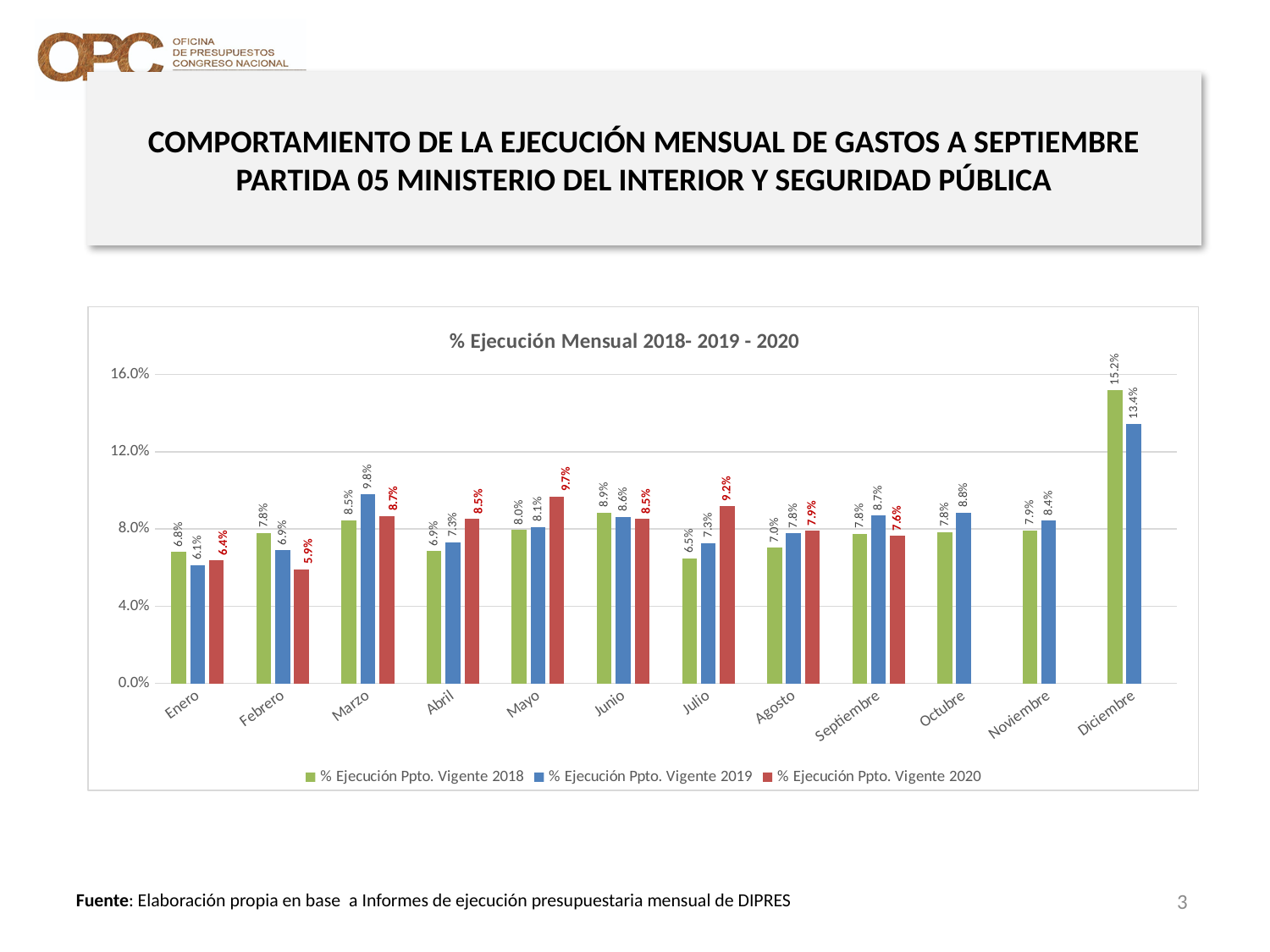
What is the difference between the 2018 and 2019 values for Diciembre? 1.8% Is the value for Diciembre in the % Ejecución Ppto. Vigente 2019 series greater or less than 12.0%? greater Which month has the highest value in the % Ejecución Ppto. Vigente 2019 series? Diciembre What is the value for Marzo in the % Ejecución Ppto. Vigente 2019 series? 9.8% What is the value for Diciembre in the % Ejecución Ppto. Vigente 2018 series? 15.2% How many series does the legend list? 3 Which month has the lowest value in the % Ejecución Ppto. Vigente 2020 series? Febrero What kind of chart is shown on the slide? Bar chart What is the value for Mayo in the % Ejecución Ppto. Vigente 2020 series? 9.7% How many months are shown on the x axis? 12 What is the title of the chart? % Ejecución Mensual 2018- 2019 - 2020 For Julio, which series has the larger value: % Ejecución Ppto. Vigente 2018 or % Ejecución Ppto. Vigente 2020? % Ejecución Ppto. Vigente 2020